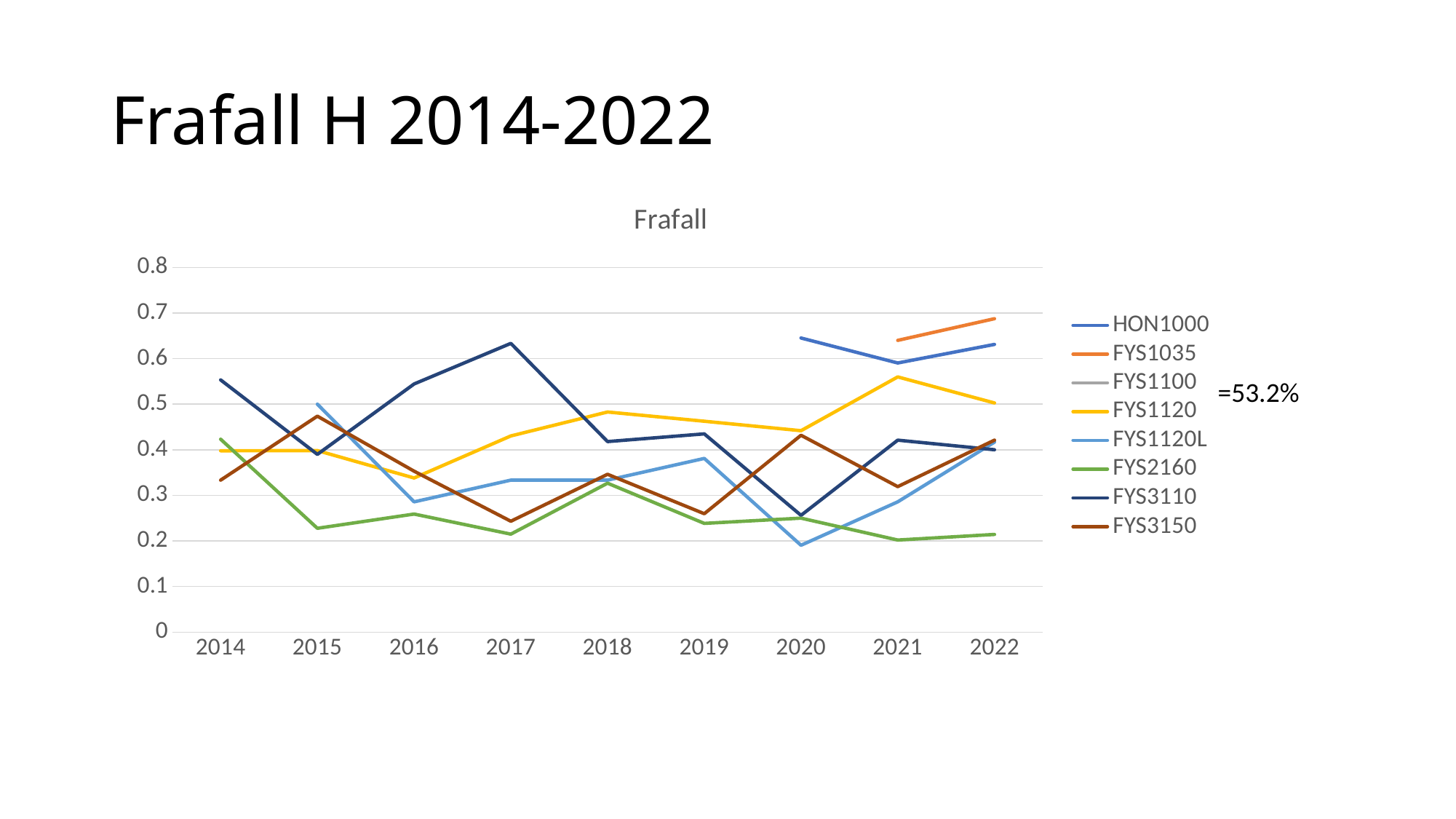
What kind of chart is shown on the slide? line chart Does the FYS1035 line rise or fall from 2021 to 2022? rise How many series does the legend of the chart list? 8 Is the value for FYS1120L in 2020 greater or less than 0.3? less Which series has the lowest value in 2021? FYS2160 Is the value for FYS2160 in 2015 greater or less than 0.3? less Is the value for FYS1120 in 2021 greater or less than 0.5? greater Which series has the highest value in 2022? FYS1035 How many years are shown along the x axis of the chart? 9 What is the title of the chart? Frafall In 2017, which is larger: the value for FYS3110 or the value for FYS2160? FYS3110